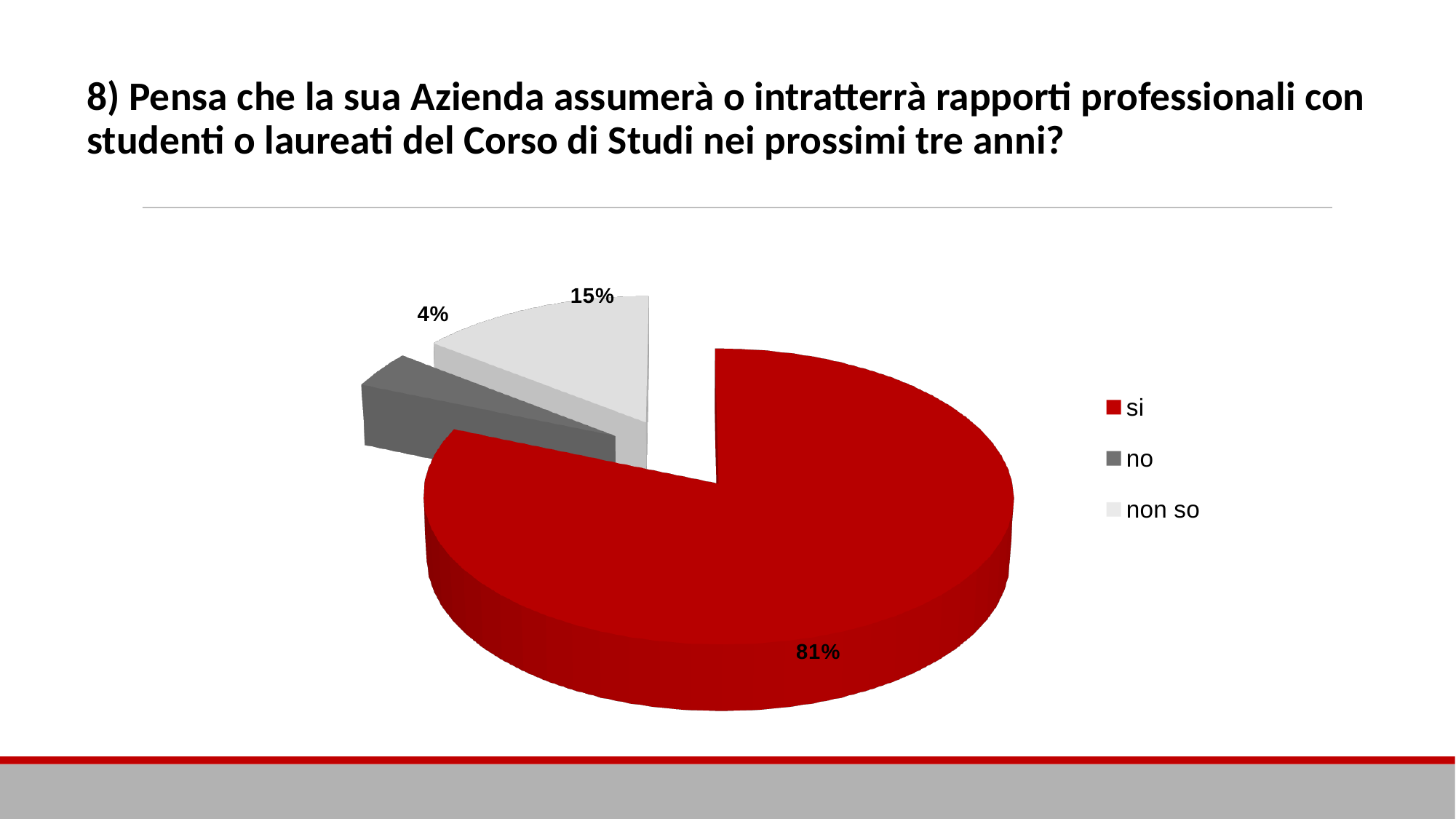
Which response has the largest share of the pie? si What percentage of respondents answered "no"? 4% What is the combined share of "no" and "non so"? 19% What is the difference in percentage points between "si" and "non so"? 66 Which is larger, the share for "no" or the share for "non so"? non so What percentage of respondents answered "non so"? 15% What is the difference in percentage points between "non so" and "no"? 11 How many categories are shown in the pie chart? 3 What percentage of respondents answered "si"? 81% Which response has the smallest share of the pie? no What colour is the slice for "si"? red What kind of chart is shown on the slide? pie chart